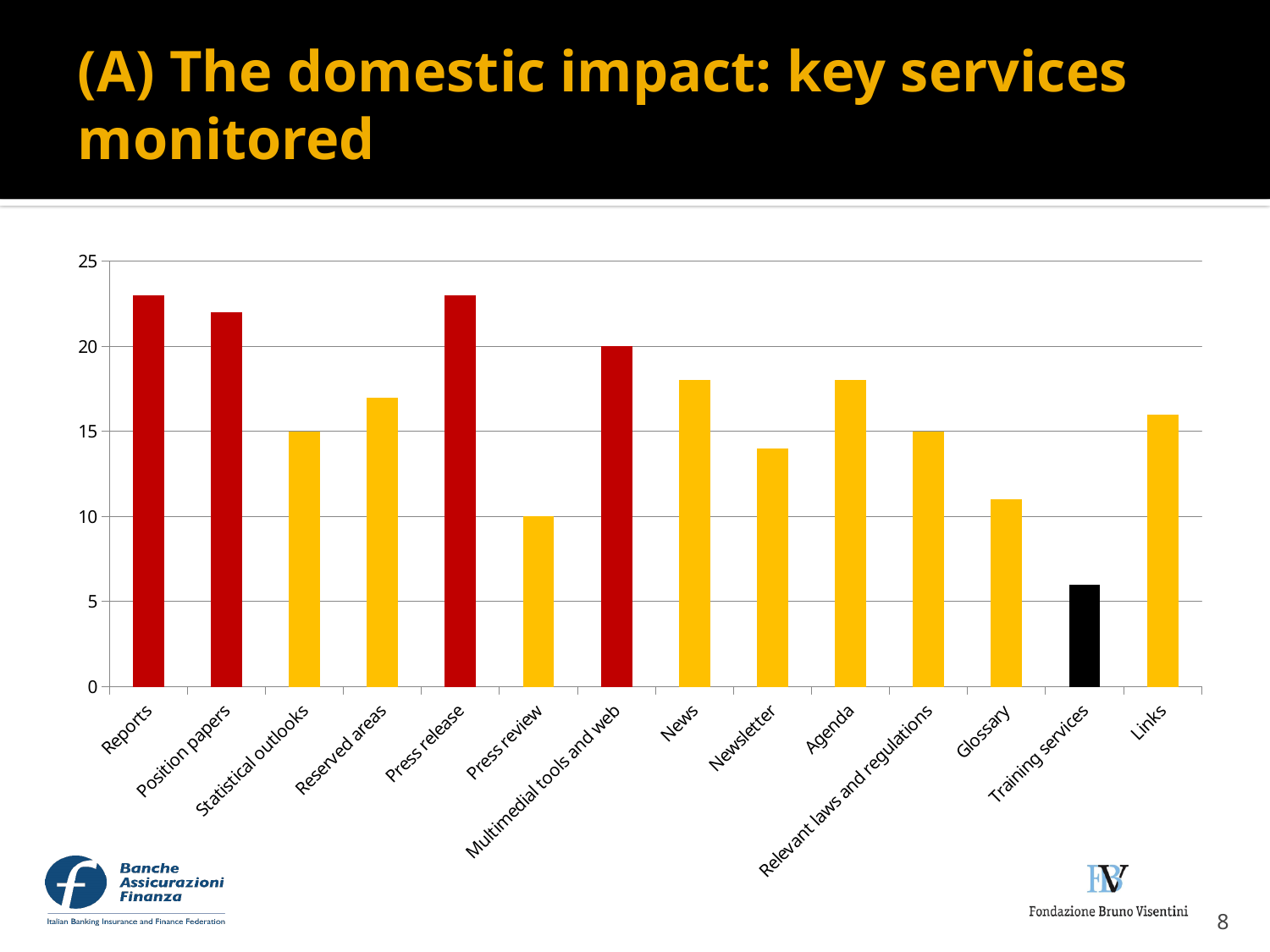
Which category has the lowest value in the chart? Training services What colour is the bar for Training services? black What is the value for Multimedial tools and web? 20 Is the value for Reports greater or less than 20? greater What is the value for Statistical outlooks? 15 What is the difference between the values for Multimedial tools and web and Press review? 10 What is the value for Relevant laws and regulations? 15 How many categories are shown on the x axis of the chart? 14 What is the value for Press review? 10 What type of chart is shown on the slide? bar chart Is the value for Training services greater or less than 10? less Which has a larger value, Position papers or Glossary? Position papers